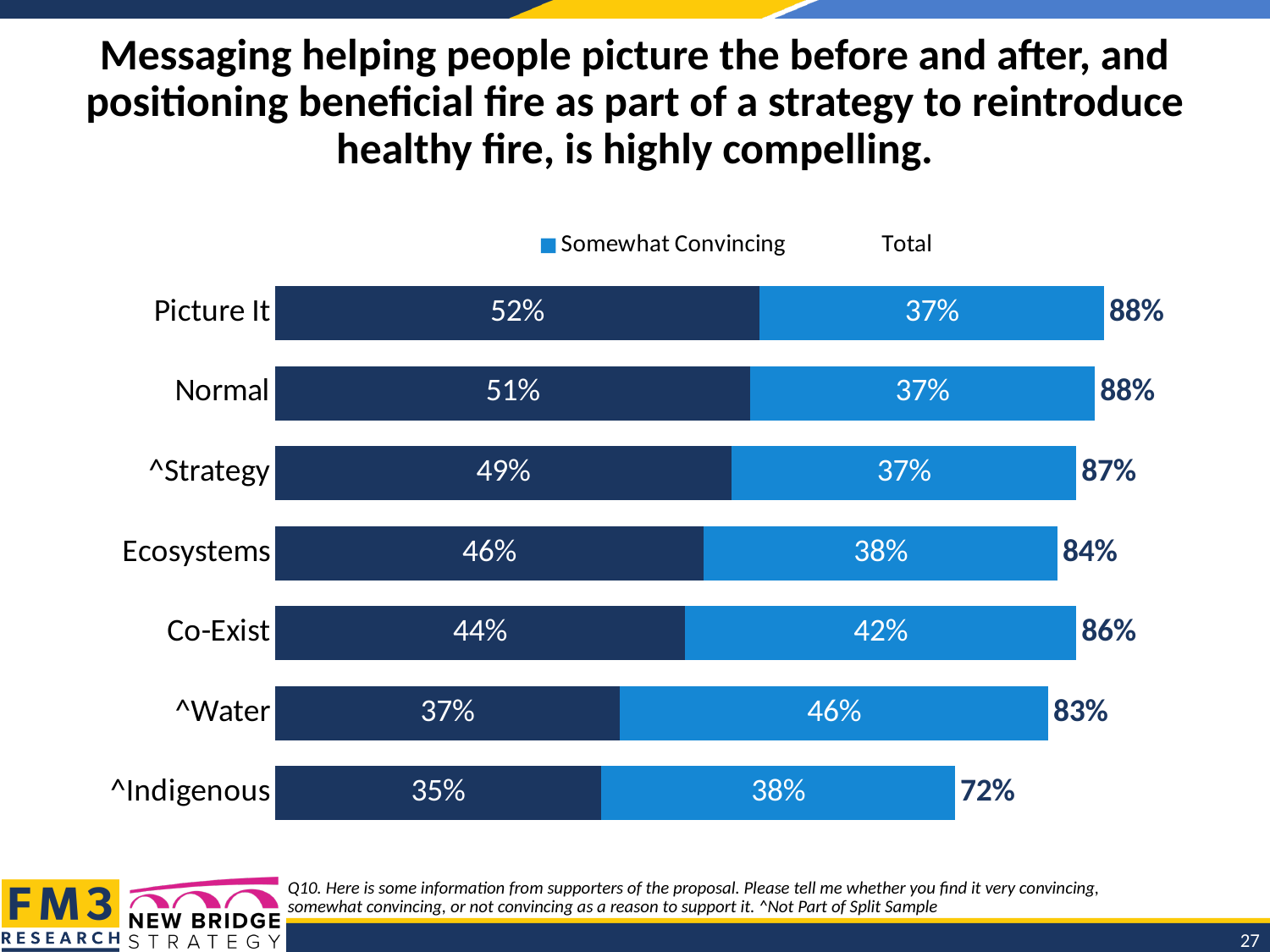
Which category is listed at the top of the chart? Picture It What is the Total value shown for Ecosystems? 84% What is the value of the dark blue segment for ^Strategy? 49% How many categories are shown in the chart? 7 What is the Total value shown for ^Indigenous? 72% What is the Somewhat Convincing value for Co-Exist? 42% What kind of chart is shown on the slide? Stacked bar chart Which category has the lowest Total value? ^Indigenous How much larger is the Somewhat Convincing value for ^Water than for Picture It? 9 percentage points What is the difference between the Total for Picture It and the Total for ^Indigenous? 16 percentage points Which has a larger Somewhat Convincing value, Co-Exist or Ecosystems? Co-Exist Which category has the highest Somewhat Convincing value? ^Water